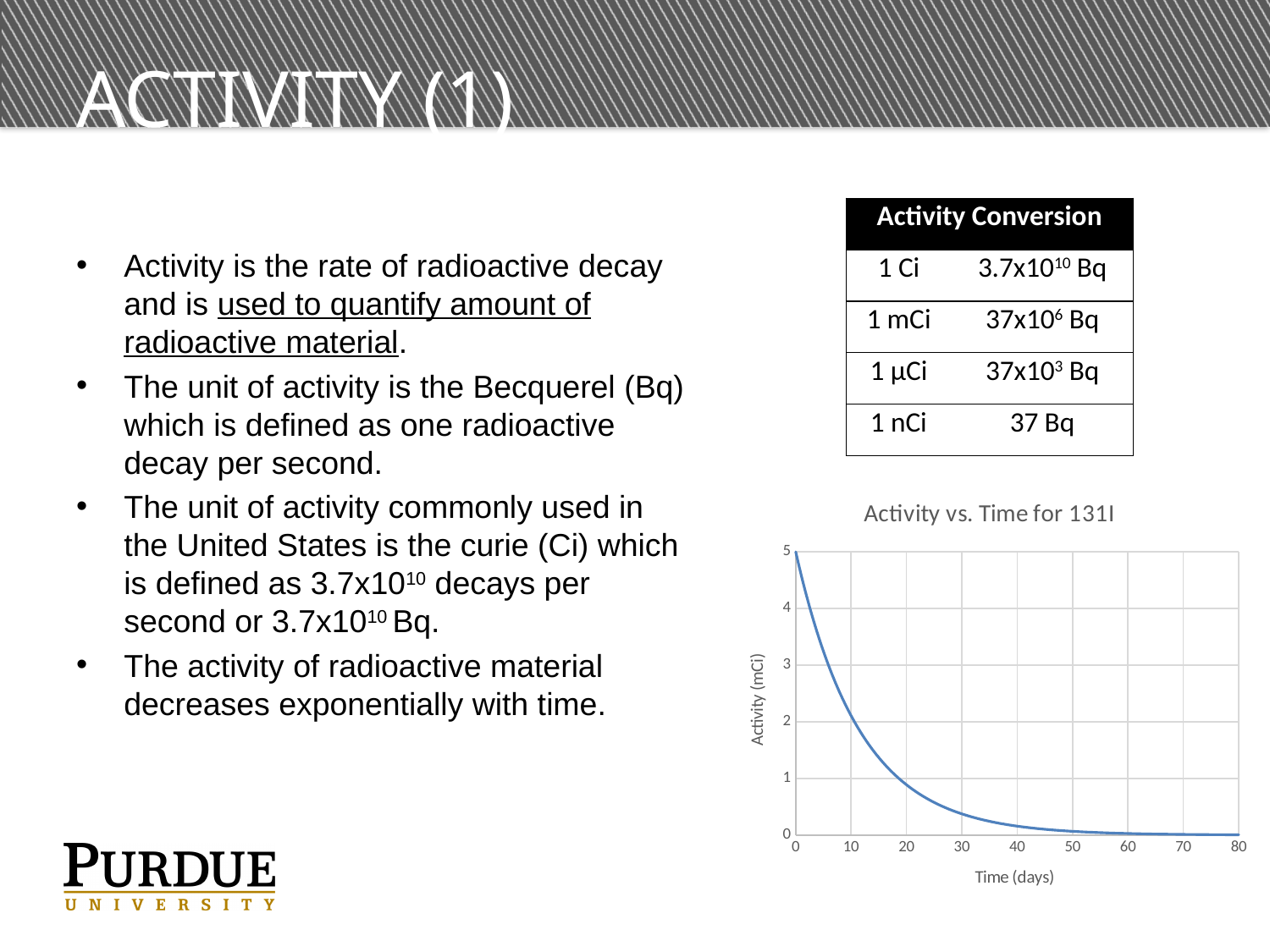
Is the activity at 40 days greater or less than 1 mCi? less Which is larger, the activity at 10 days or the activity at 30 days? 10 days What is the label of the vertical axis of the chart? Activity (mCi) What is the activity in mCi at time 0 days? 5 Which is larger, the activity at 20 days or the activity at 60 days? 20 days Is the activity at 20 days greater or less than 2 mCi? less Is the activity at 10 days greater or less than 3 mCi? less At which time on the x axis is the activity highest? 0 days What is the title of the chart? Activity vs. Time for 131I What kind of chart is shown on the slide? line chart Does the activity rise or fall as time increases along the x axis? fall